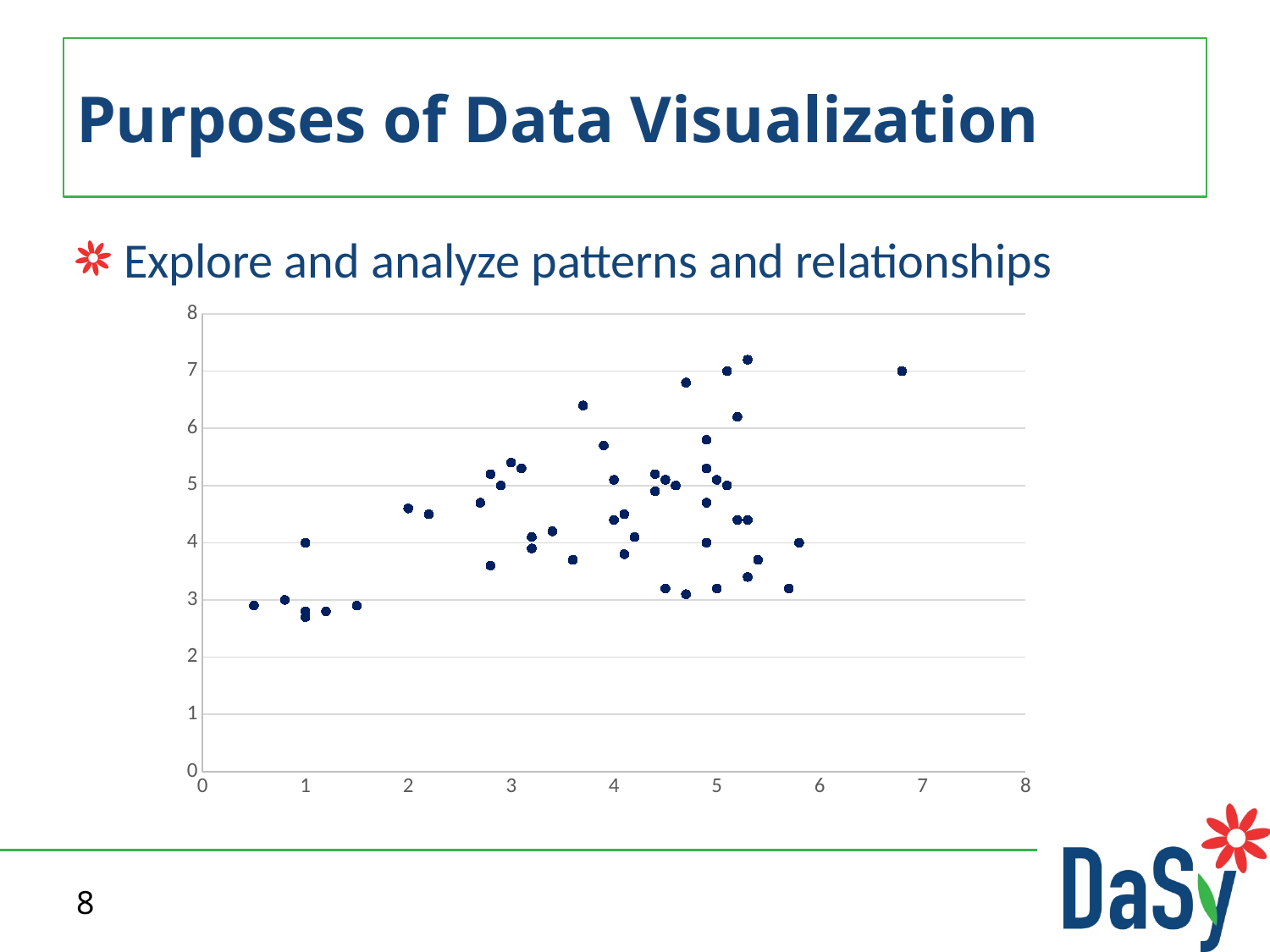
Do the plotted y values generally rise or fall as the x values increase? rise What is the highest value shown on the horizontal axis of the chart? 8 What is the highest value shown on the vertical axis of the chart? 8 What kind of chart is shown on the slide? scatter chart